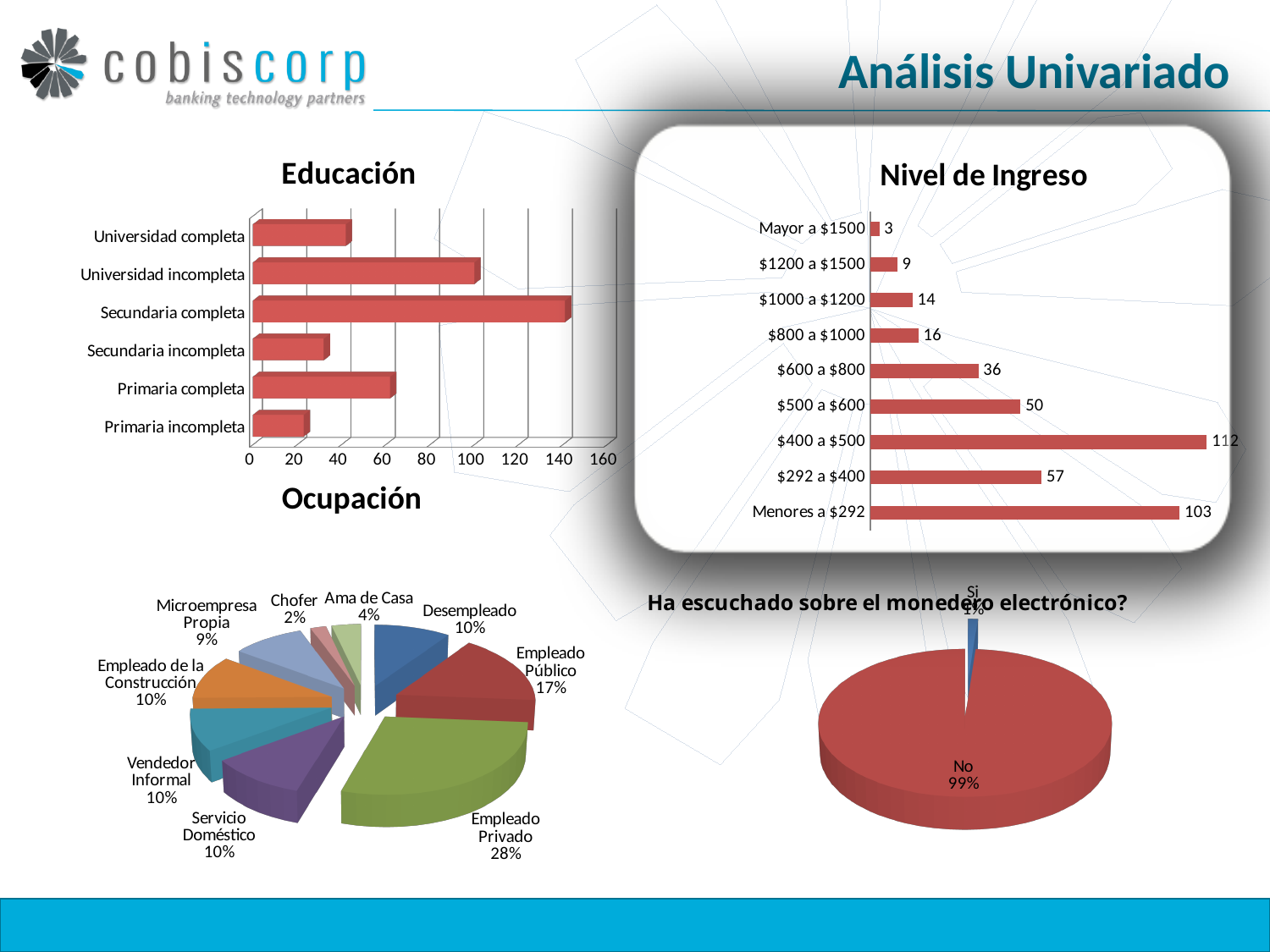
In the Ocupación pie chart, what share does Empleado Privado have? 28% In the Educación chart, which category has the shortest bar? Primaria incompleta In the Nivel de Ingreso chart, which income range has the lowest value? Mayor a $1500 In the Nivel de Ingreso chart, how many income ranges are shown? 9 In the Nivel de Ingreso chart, what is the value for Menores a $292? 103 In the Ocupación pie chart, which is larger, Empleado Público or Desempleado? Empleado Público In the Educación chart, which category has the longest bar? Secundaria completa In the Educación chart, is the value for Primaria incompleta greater or less than 40? less In the Nivel de Ingreso chart, what is the difference between the values for $400 a $500 and Menores a $292? 9 In the Nivel de Ingreso chart, what is the value for $400 a $500? 112 In the chart titled 'Ha escuchado sobre el monedero electrónico?', what percentage answered No? 99%